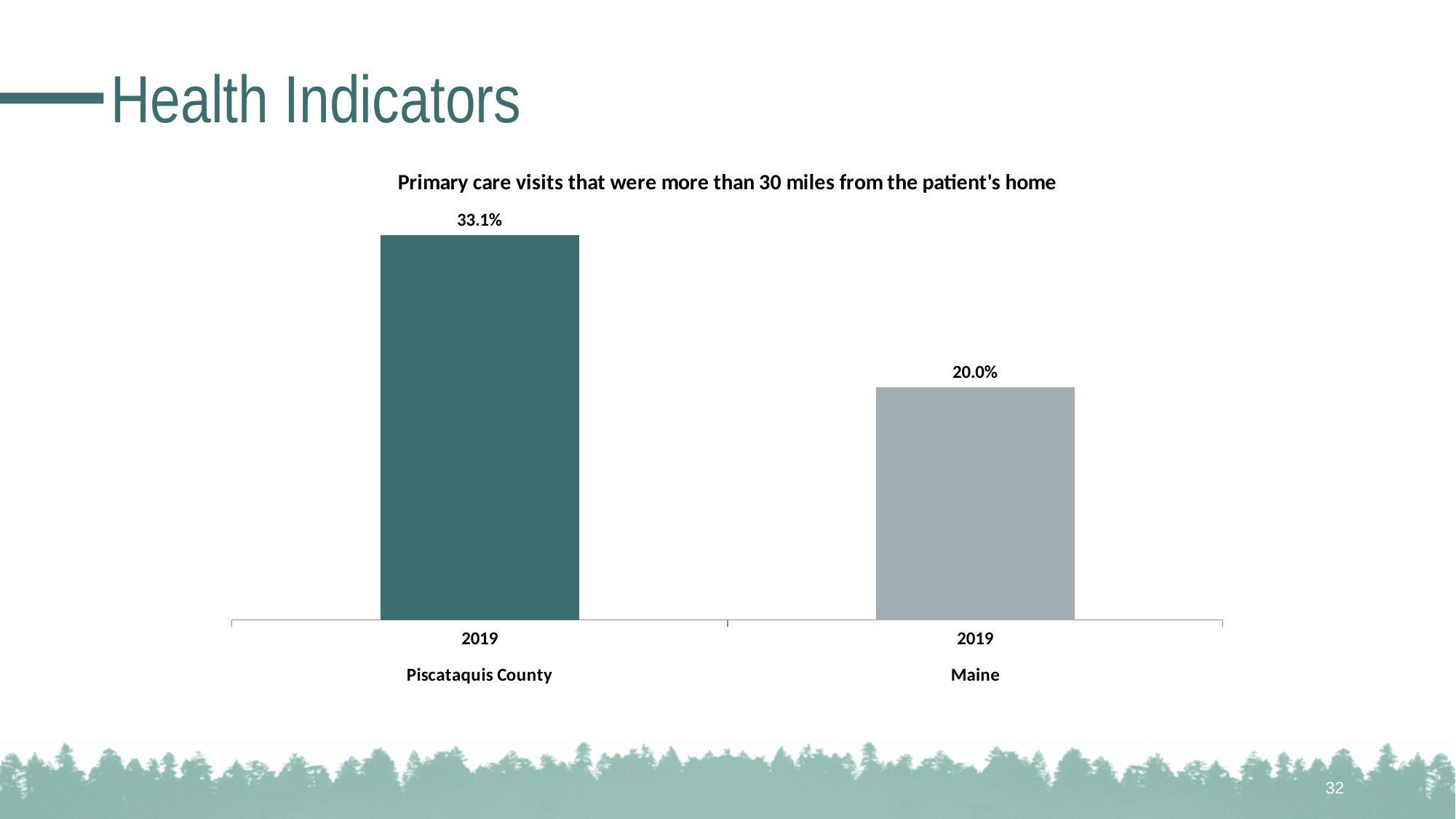
What kind of chart is shown on the slide? Bar chart What is the value for Maine in 2019? 20.0% What is the title of the chart? Primary care visits that were more than 30 miles from the patient's home What is the difference between the Piscataquis County value and the Maine value? 13.1% What year is shown for both bars in the chart? 2019 Which category has the lowest value? Maine What is the value for Piscataquis County in 2019? 33.1% How many bars are plotted in the chart? 2 Which is larger, the value for Piscataquis County or the value for Maine? Piscataquis County Which category has the highest value? Piscataquis County